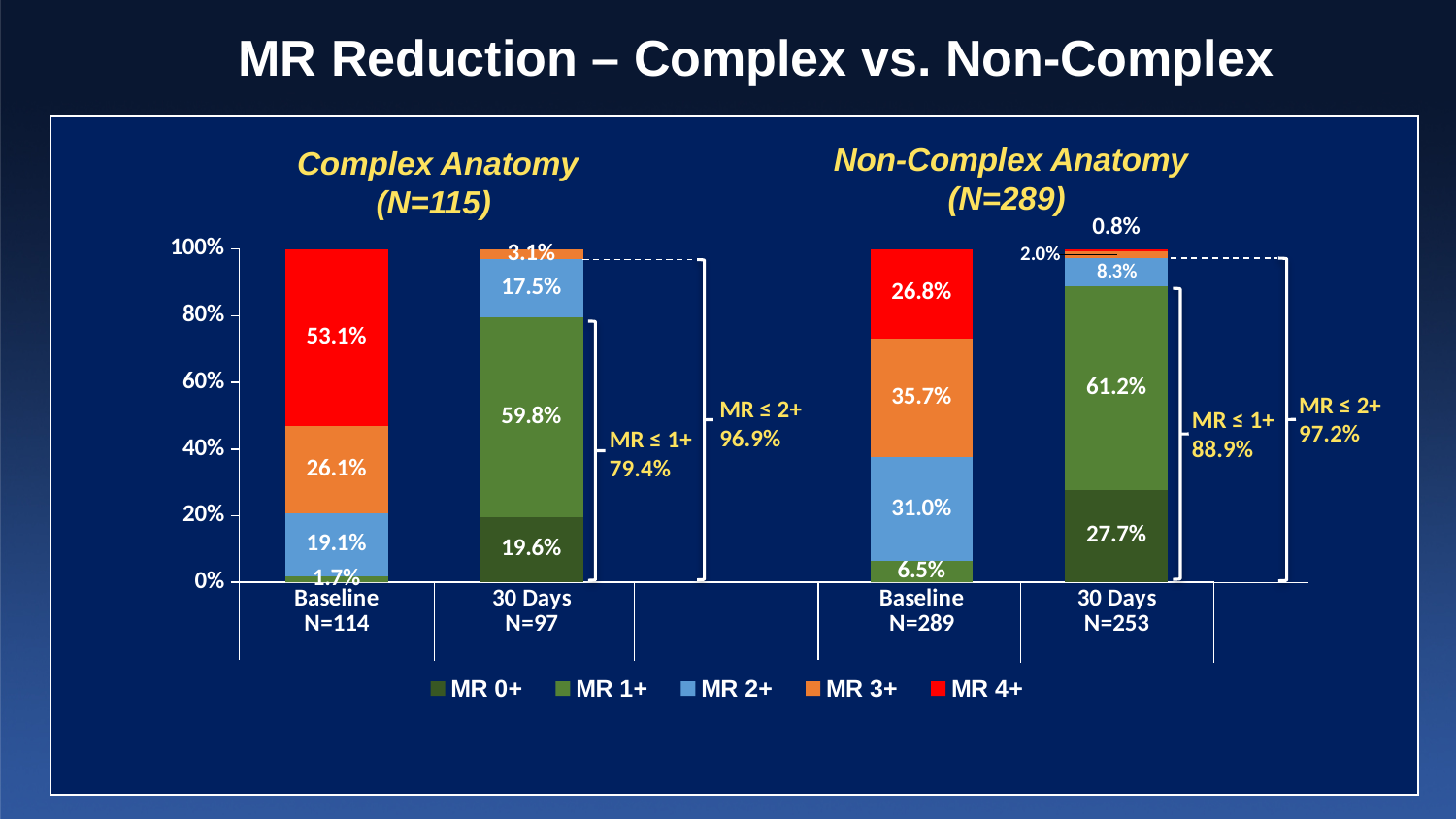
What is the MR 4+ share for the Complex Anatomy Baseline bar? 53.1% Which MR grade has the largest share in the Complex Anatomy Baseline bar? MR 4+ What percentage of Complex Anatomy patients had MR ≤ 2+ at 30 days? 96.9% How many series does the legend list? 5 Which is larger: the MR 2+ share at 30 Days for Complex Anatomy or for Non-Complex Anatomy? Complex Anatomy Which MR grade has the smallest share in the Non-Complex Anatomy Baseline bar? MR 1+ What kind of chart is shown on the slide? Stacked bar chart What percentage of Non-Complex Anatomy patients had MR ≤ 1+ at 30 days? 88.9% What is the MR 1+ share for the Non-Complex Anatomy 30 Days bar? 61.2% What is the MR 3+ share for the Non-Complex Anatomy Baseline bar? 35.7% What is the MR 0+ share for the Complex Anatomy 30 Days bar? 19.6%